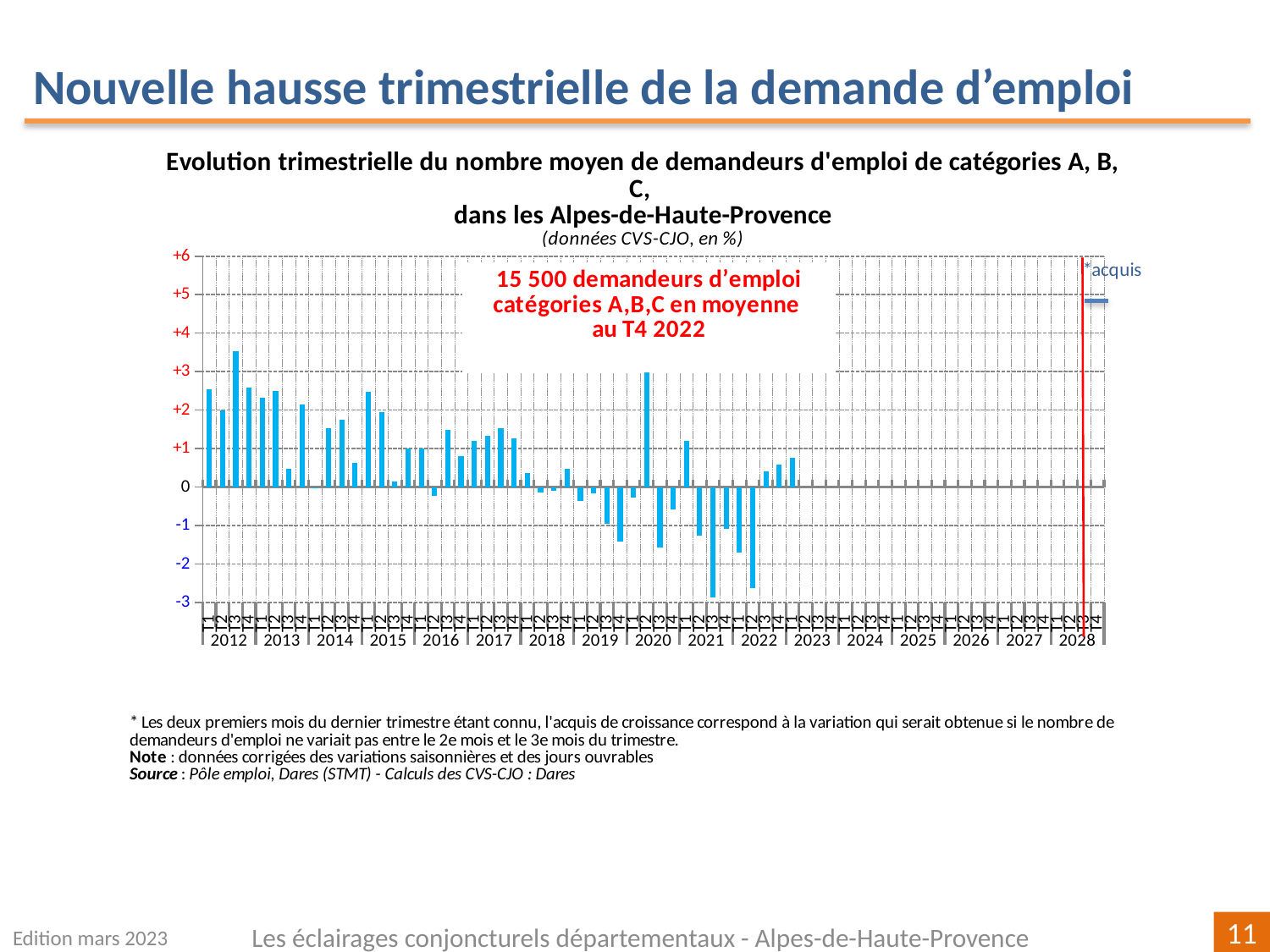
Is the value for T4 2022 greater or less than +1? less Which is larger, the value for T1 2012 or the value for T2 2012? T1 2012 From T2 2022 to T4 2022, do the bars rise or fall? rise How many year labels appear along the x axis of the chart? 17 What kind of chart is shown on the slide? bar chart Is the value for T1 2020 greater or less than +2? less Is the value for T2 2021 greater or less than -2? greater According to the red annotation on the chart, how many demandeurs d'emploi catégories A,B,C were there on average in T4 2022? 15 500 Which is larger, the value for T1 2021 or the value for T2 2021? T1 2021